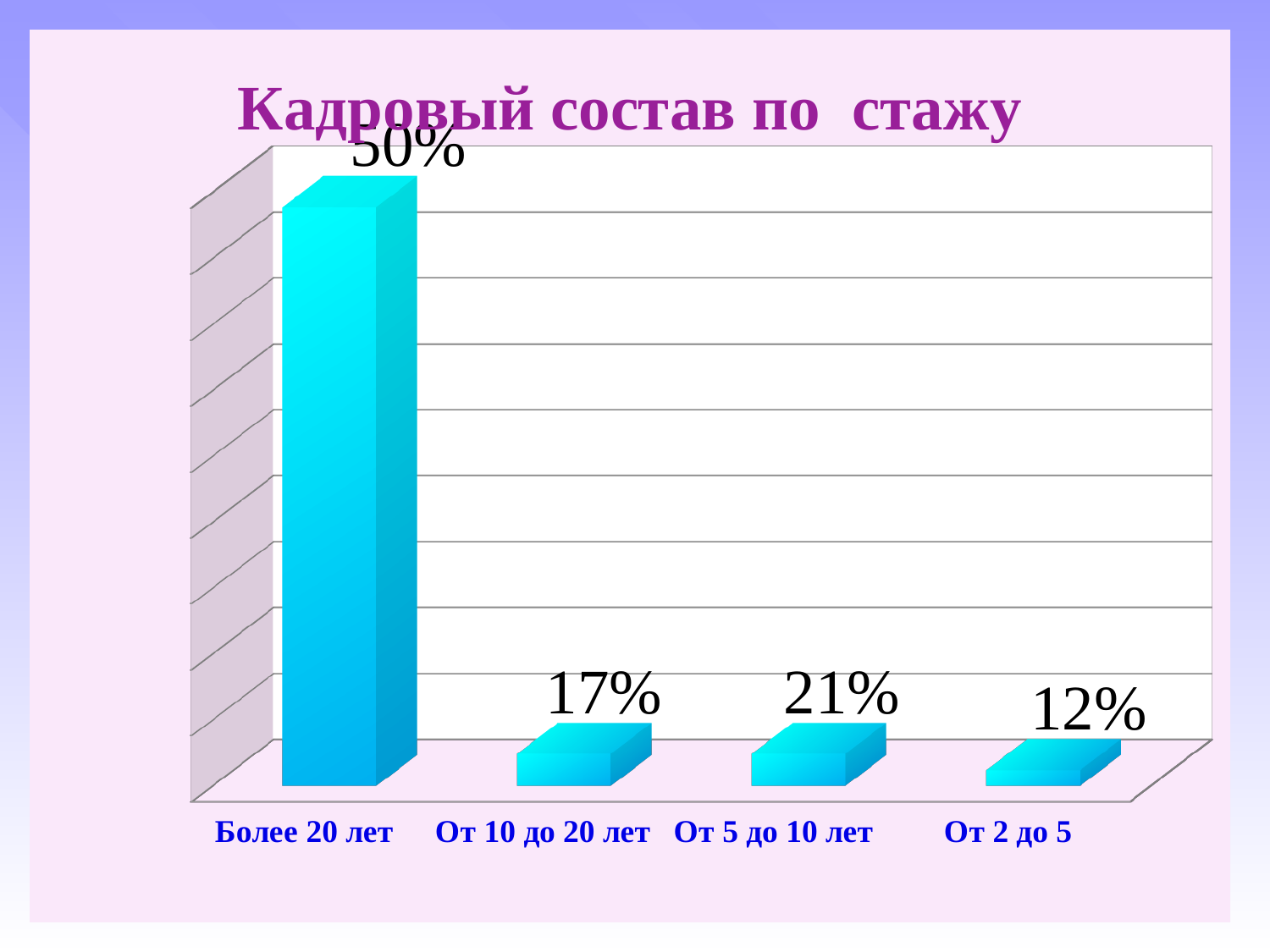
What is the difference between the values for От 5 до 10 лет and От 10 до 20 лет? 4% What is the value for От 2 до 5? 12% What is the value for Более 20 лет? 50% What is the difference between the values for Более 20 лет and От 5 до 10 лет? 29% What is the value for От 5 до 10 лет? 21% What kind of chart is shown on the slide? Bar chart Which is larger, the value for От 10 до 20 лет or the value for От 5 до 10 лет? От 5 до 10 лет Which category has the highest value? Более 20 лет How many categories are shown in the chart? 4 What is the value for От 10 до 20 лет? 17% Which category has the lowest value? От 2 до 5 What is the title of the chart? Кадровый состав по стажу